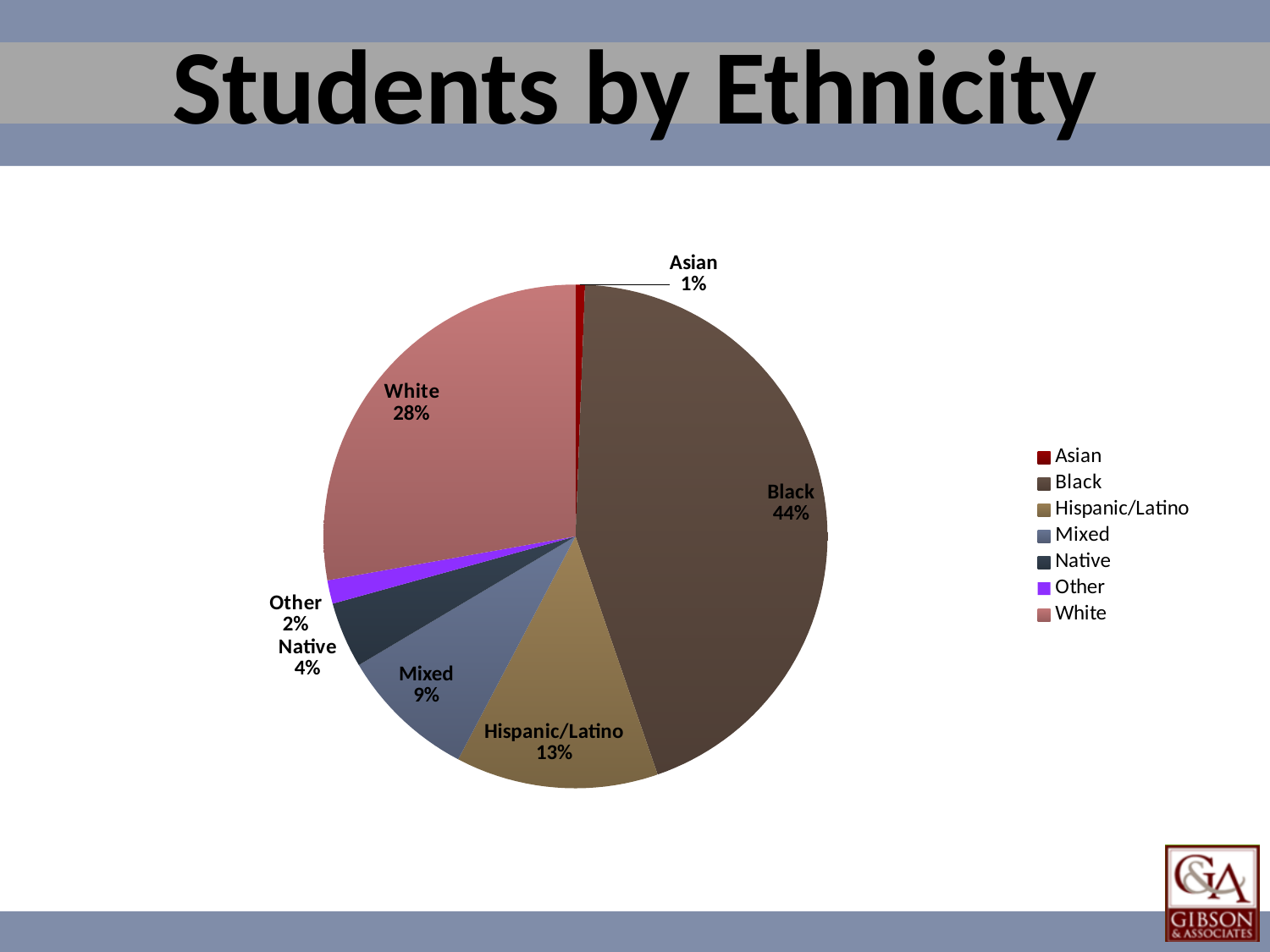
What share of students are Hispanic/Latino? 13% What share of students are Native? 4% What is the title of the chart? Students by Ethnicity What is the difference in percentage points between the Black and White shares? 16 Which ethnicity has the smallest share of students? Asian What share of students are Mixed? 9% What share of students are Black? 44% Which is larger, the Mixed share or the Hispanic/Latino share? Hispanic/Latino Which ethnicity has the largest share of students? Black What share of students are White? 28% What kind of chart is shown on the slide? pie chart How many ethnicity categories does the pie chart show? 7